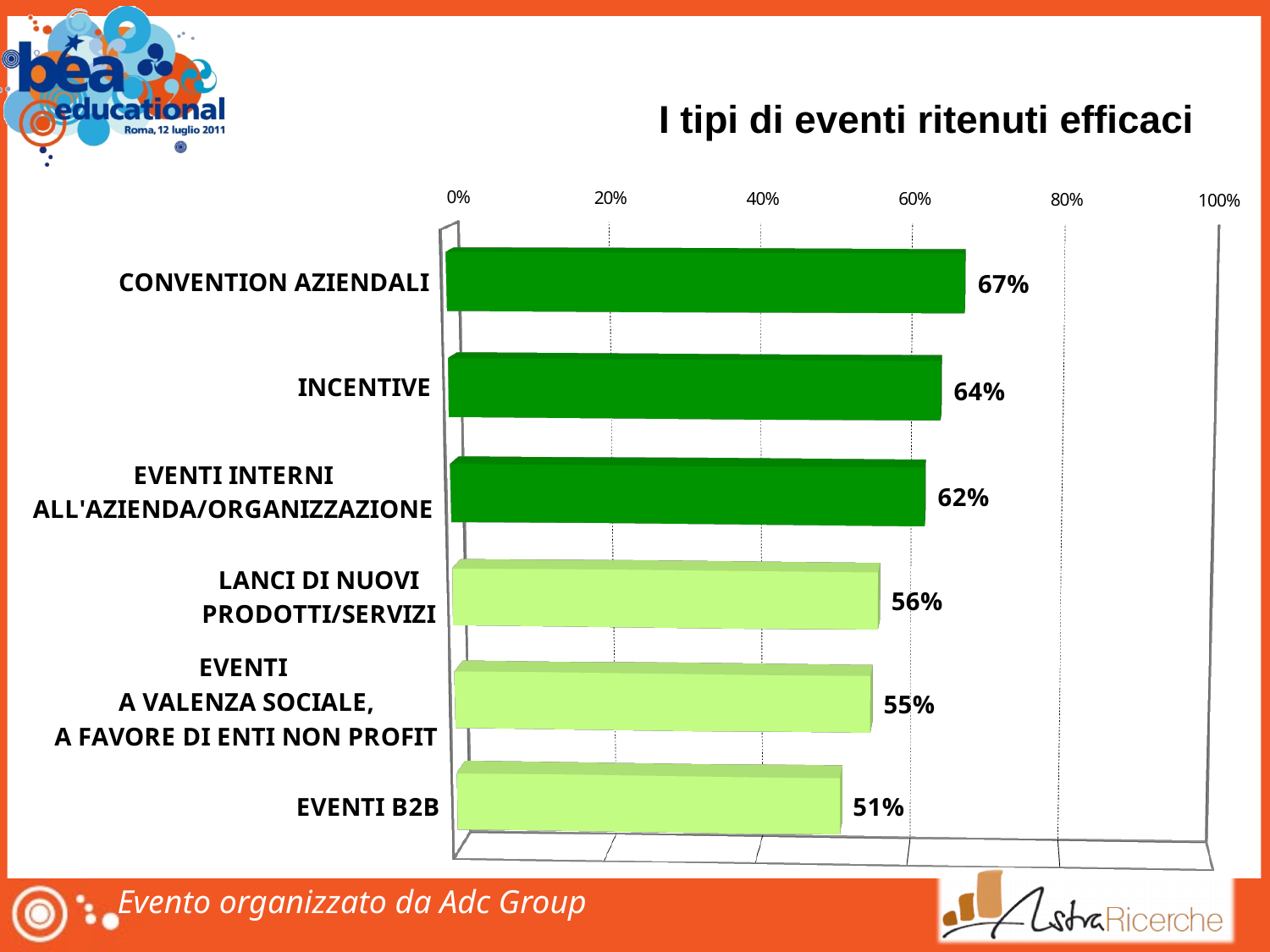
What is the value for INCENTIVE? 64% What is the value for LANCI DI NUOVI PRODOTTI/SERVIZI? 56% What is the difference between the values for CONVENTION AZIENDALI and EVENTI B2B? 16% What is the title of the chart? I tipi di eventi ritenuti efficaci Which category has the lowest value? EVENTI B2B What is the value for EVENTI B2B? 51% Which is larger, the value for LANCI DI NUOVI PRODOTTI/SERVIZI or the value for EVENTI A VALENZA SOCIALE, A FAVORE DI ENTI NON PROFIT? LANCI DI NUOVI PRODOTTI/SERVIZI Which category has the highest value? CONVENTION AZIENDALI What is the difference between the values for INCENTIVE and EVENTI INTERNI ALL'AZIENDA/ORGANIZZAZIONE? 2% What is the value for CONVENTION AZIENDALI? 67% How many categories are shown in the chart? 6 What kind of chart is shown on the slide? Bar chart